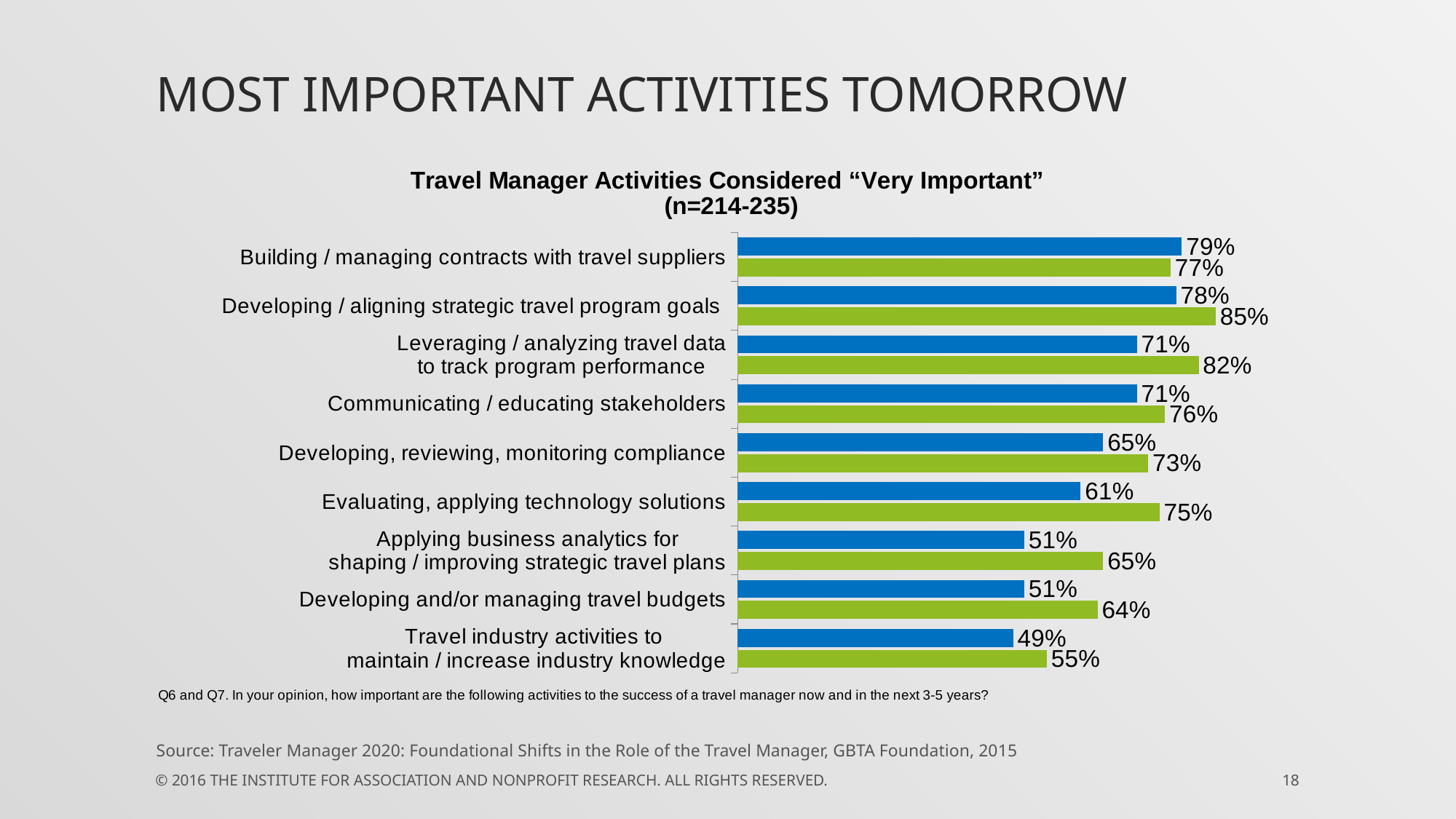
What is the title of the chart? Travel Manager Activities Considered "Very Important" (n=214-235) For "Building / managing contracts with travel suppliers", which bar is larger, the blue or the green? blue Which activity has the lowest blue bar value? Travel industry activities to maintain / increase industry knowledge What type of chart is shown on the slide? bar chart How many data series (bar colours) are plotted for each activity? 2 What is the value of the blue bar for "Developing and/or managing travel budgets"? 51% What is the value of the green bar for "Developing / aligning strategic travel program goals"? 85% What is the value of the blue bar for "Building / managing contracts with travel suppliers"? 79% How many activities are listed on the chart? 9 What is the value of the green bar for "Evaluating, applying technology solutions"? 75% Which activity has the highest green bar value? Developing / aligning strategic travel program goals What is the difference between the green and blue bar values for "Evaluating, applying technology solutions"? 14%